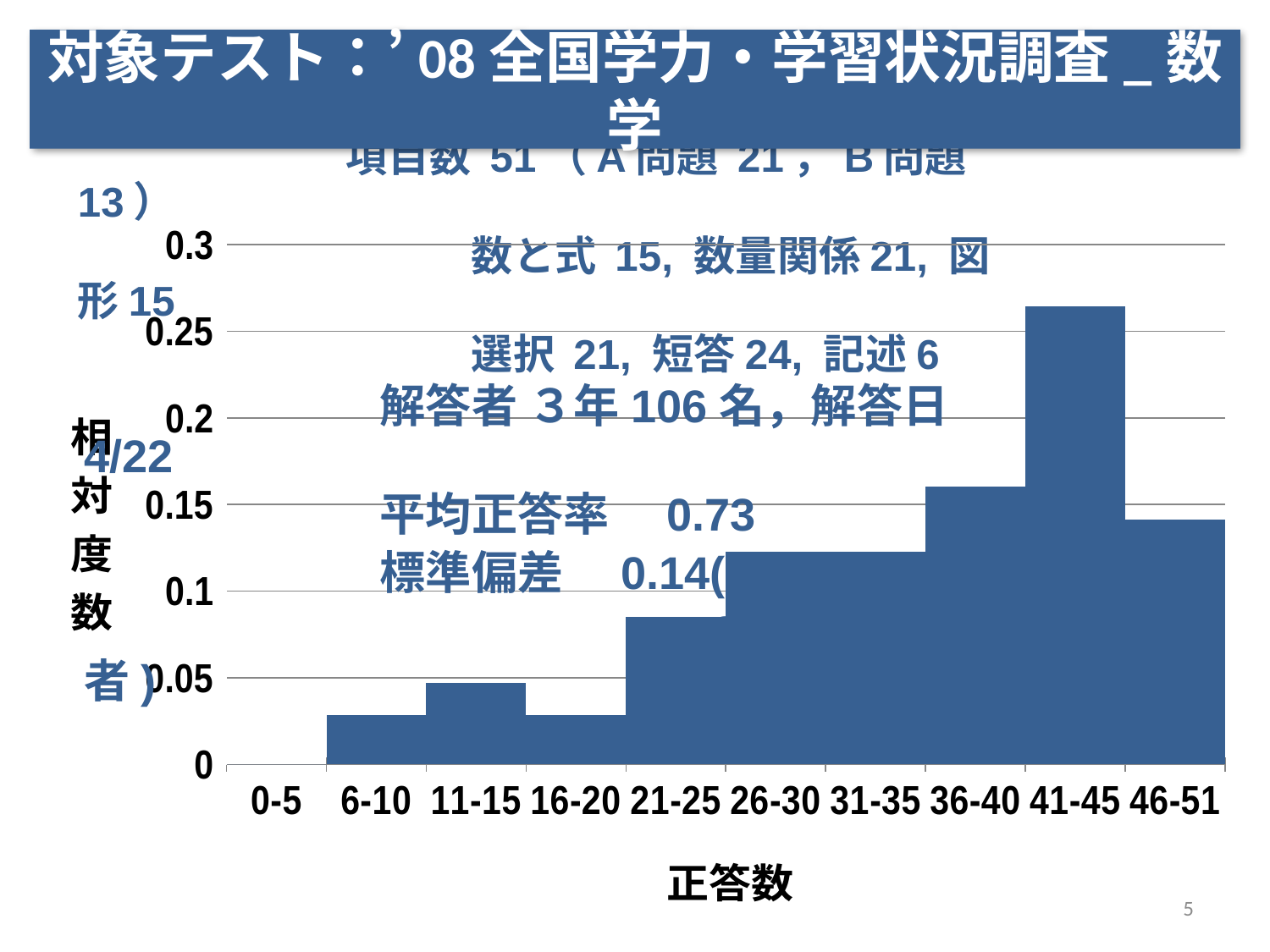
Which category has the highest relative frequency (相対度数)? 41-45 How many categories are shown on the x axis of the chart? 10 Which is larger, the value for 41-45 or the value for 46-51? 41-45 Is the value for 6-10 greater or less than 0.05? less Do the values generally rise or fall from the 0-5 category to the 41-45 category? rise What is the label of the x axis of the chart? 正答数 Which category has the lowest relative frequency (相対度数)? 0-5 Which is larger, the value for 11-15 or the value for 16-20? 11-15 Is the value for 21-25 greater or less than 0.1? less Is the value for 36-40 greater or less than 0.15? greater What kind of chart is shown on the slide? bar chart